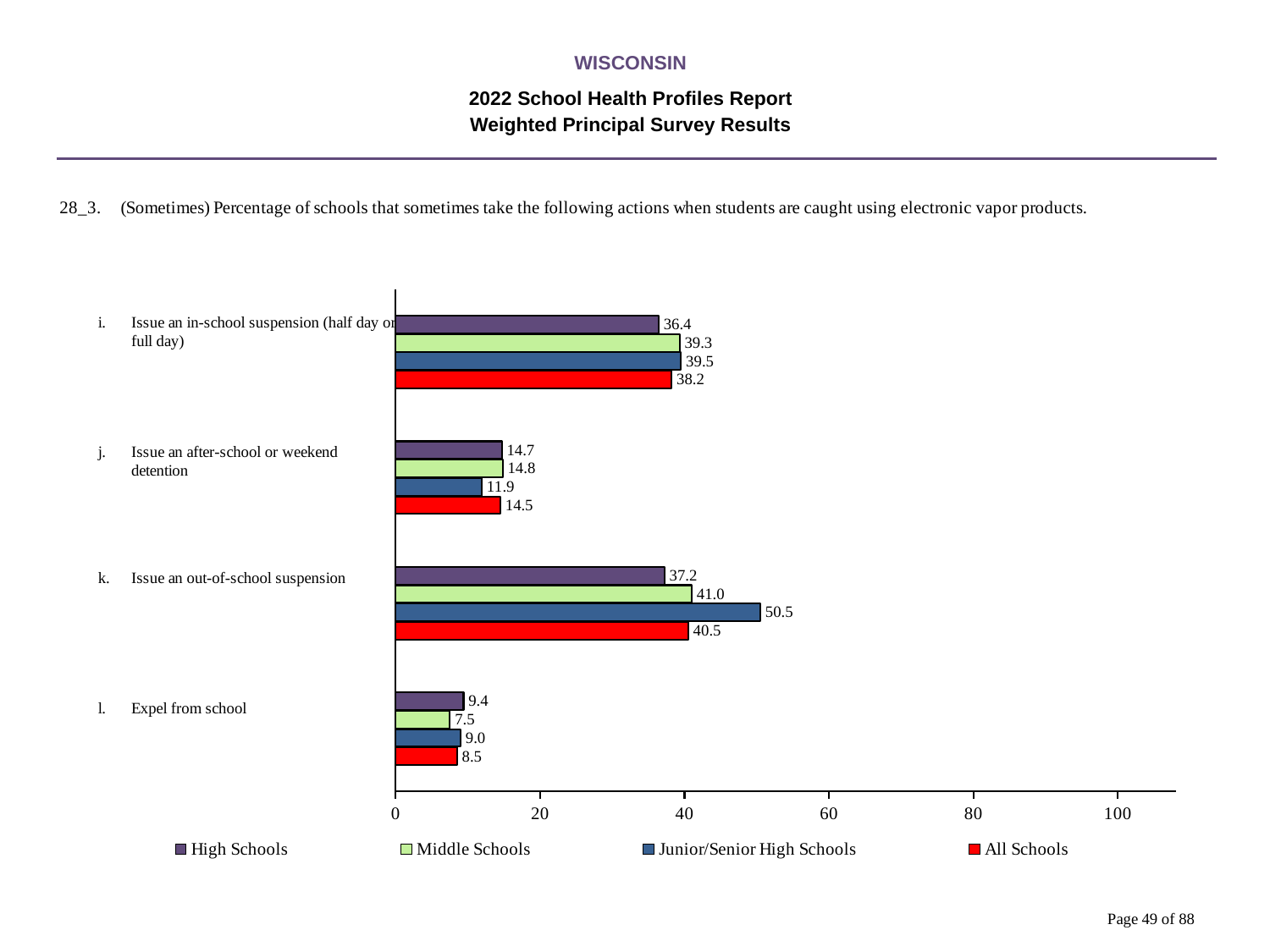
What is the value for High Schools for "Issue an in-school suspension (half day or full day)"? 36.4 How many action categories are shown in the chart? 4 For "Issue an after-school or weekend detention", which is larger: the High Schools value or the Junior/Senior High Schools value? High Schools How many series does the legend list? 4 Which school type has the highest value for "Issue an out-of-school suspension"? Junior/Senior High Schools Which school type has the lowest value for "Expel from school"? Middle Schools What is the value for All Schools for "Expel from school"? 8.5 What kind of chart is shown on the slide? Bar chart Is the All Schools value for "Issue an out-of-school suspension" greater or less than 40? greater What is the difference between the Junior/Senior High Schools and High Schools values for "Issue an out-of-school suspension"? 13.3 What is the value for Middle Schools for "Issue an after-school or weekend detention"? 14.8 What is the value for Junior/Senior High Schools for "Issue an out-of-school suspension"? 50.5